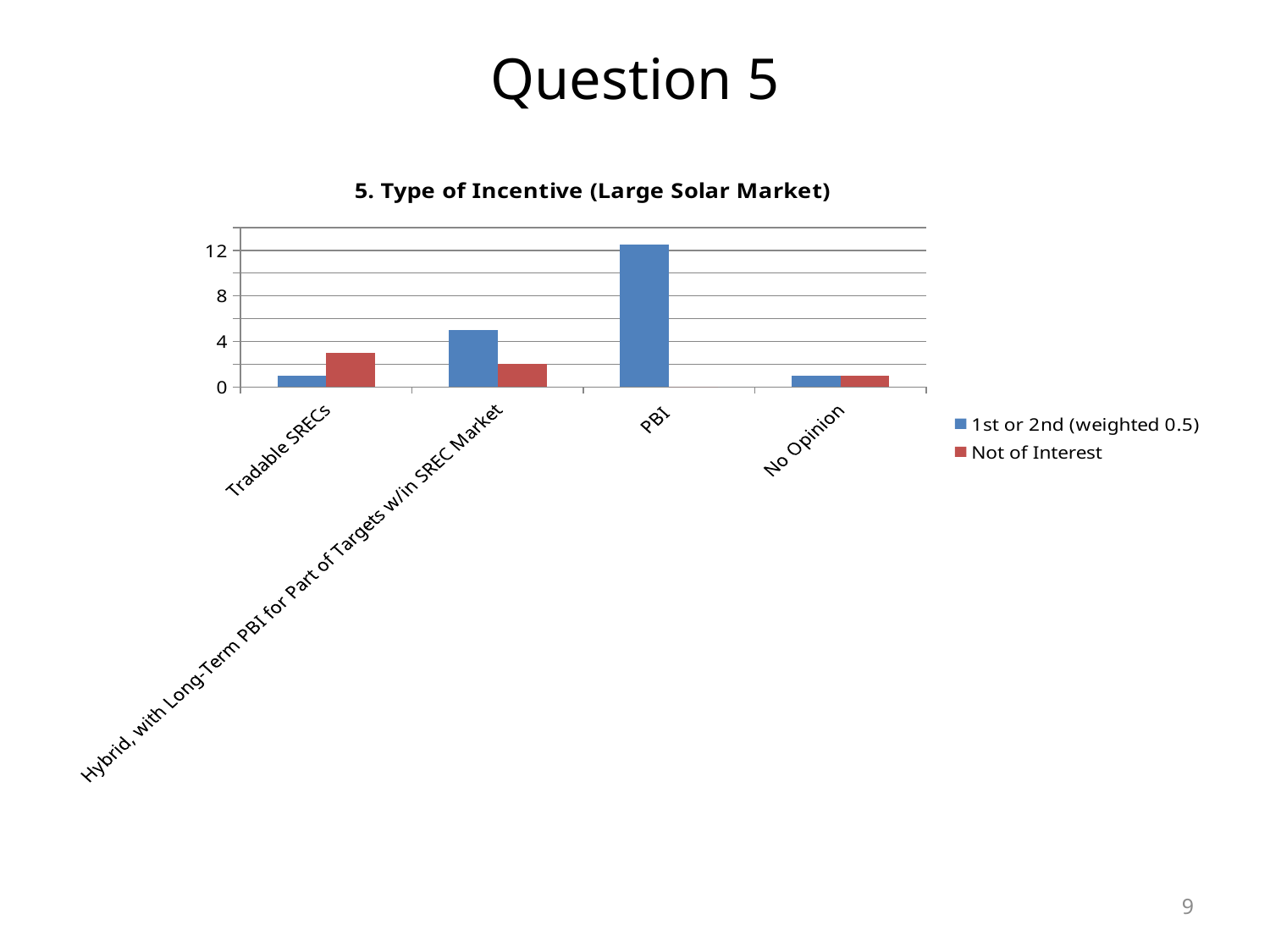
For the Hybrid category, which series has the larger value: '1st or 2nd (weighted 0.5)' or 'Not of Interest'? 1st or 2nd (weighted 0.5) Is the '1st or 2nd (weighted 0.5)' value for PBI greater or less than 8? greater Which category has the highest value for the '1st or 2nd (weighted 0.5)' series? PBI Which colour represents the 'Not of Interest' series? red What is the title of the chart? 5. Type of Incentive (Large Solar Market) For Tradable SRECs, which series has the larger value: '1st or 2nd (weighted 0.5)' or 'Not of Interest'? Not of Interest Is the '1st or 2nd (weighted 0.5)' value for the Hybrid category greater or less than 4? greater Is the 'Not of Interest' value for Tradable SRECs greater or less than 4? less Which category has the highest 'Not of Interest' value? Tradable SRECs What type of chart is shown on the slide? bar chart How many categories are shown on the x axis? 4 How many series does the legend list? 2